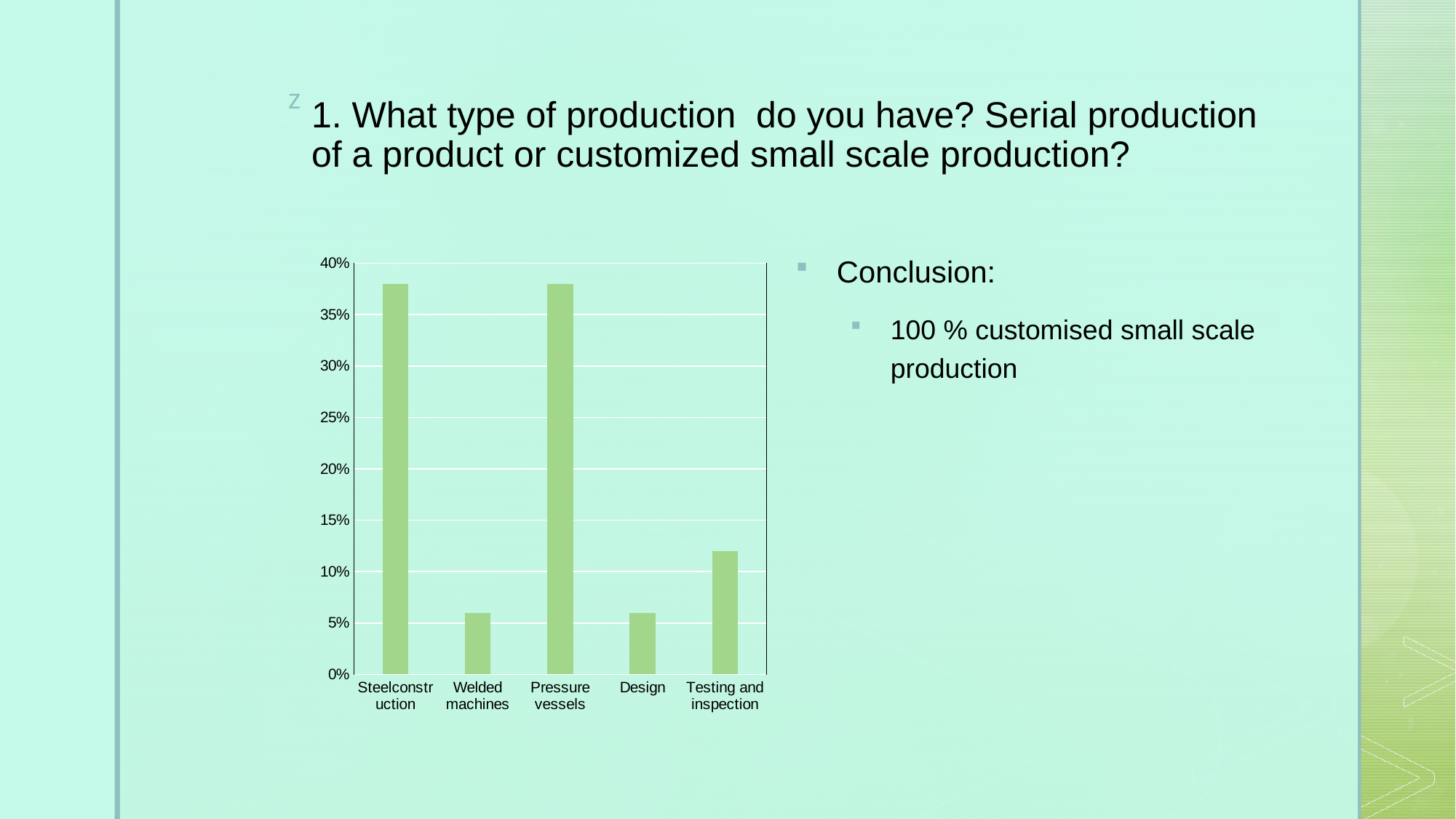
How many categories are shown on the x axis of the chart? 5 What kind of chart is shown on the slide? bar chart What is the highest value shown on the y axis of the chart? 40% Is the value for Testing and inspection greater or less than 10%? greater Is the value for Testing and inspection greater or less than 15%? less Is the value for Pressure vessels greater or less than 30%? greater Which is larger, the value for Design or the value for Testing and inspection? Testing and inspection Which is larger, the value for Steelconstruction or the value for Welded machines? Steelconstruction Which is larger, the value for Pressure vessels or the value for Testing and inspection? Pressure vessels